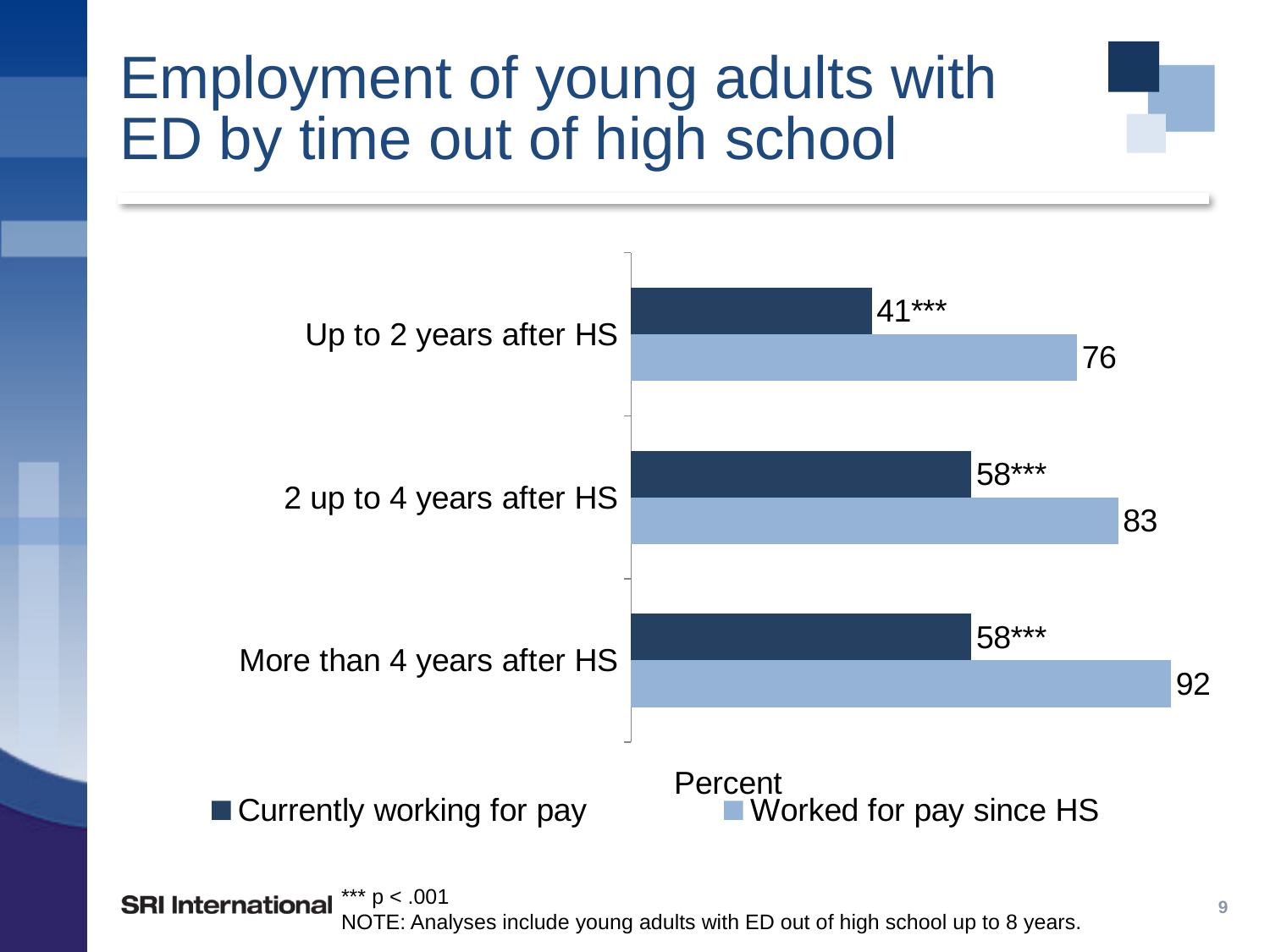
What kind of chart is shown on the slide? Bar chart How many series does the legend list? 2 What is the difference between 'Worked for pay since HS' and 'Currently working for pay' for 'Up to 2 years after HS'? 35 What is the value for 'Worked for pay since HS' for '2 up to 4 years after HS'? 83 Does the 'Worked for pay since HS' series rise or fall from 'Up to 2 years after HS' to 'More than 4 years after HS'? Rise What is the difference in 'Worked for pay since HS' between 'More than 4 years after HS' and 'Up to 2 years after HS'? 16 Which is larger: 'Currently working for pay' for '2 up to 4 years after HS' or 'Worked for pay since HS' for 'Up to 2 years after HS'? Worked for pay since HS for Up to 2 years after HS Which category has the lowest value for 'Currently working for pay'? Up to 2 years after HS How many categories are shown on the chart? 3 What is the value for 'Currently working for pay' for 'Up to 2 years after HS'? 41 Which category has the highest value for 'Worked for pay since HS'? More than 4 years after HS What is the value for 'Worked for pay since HS' for 'More than 4 years after HS'? 92